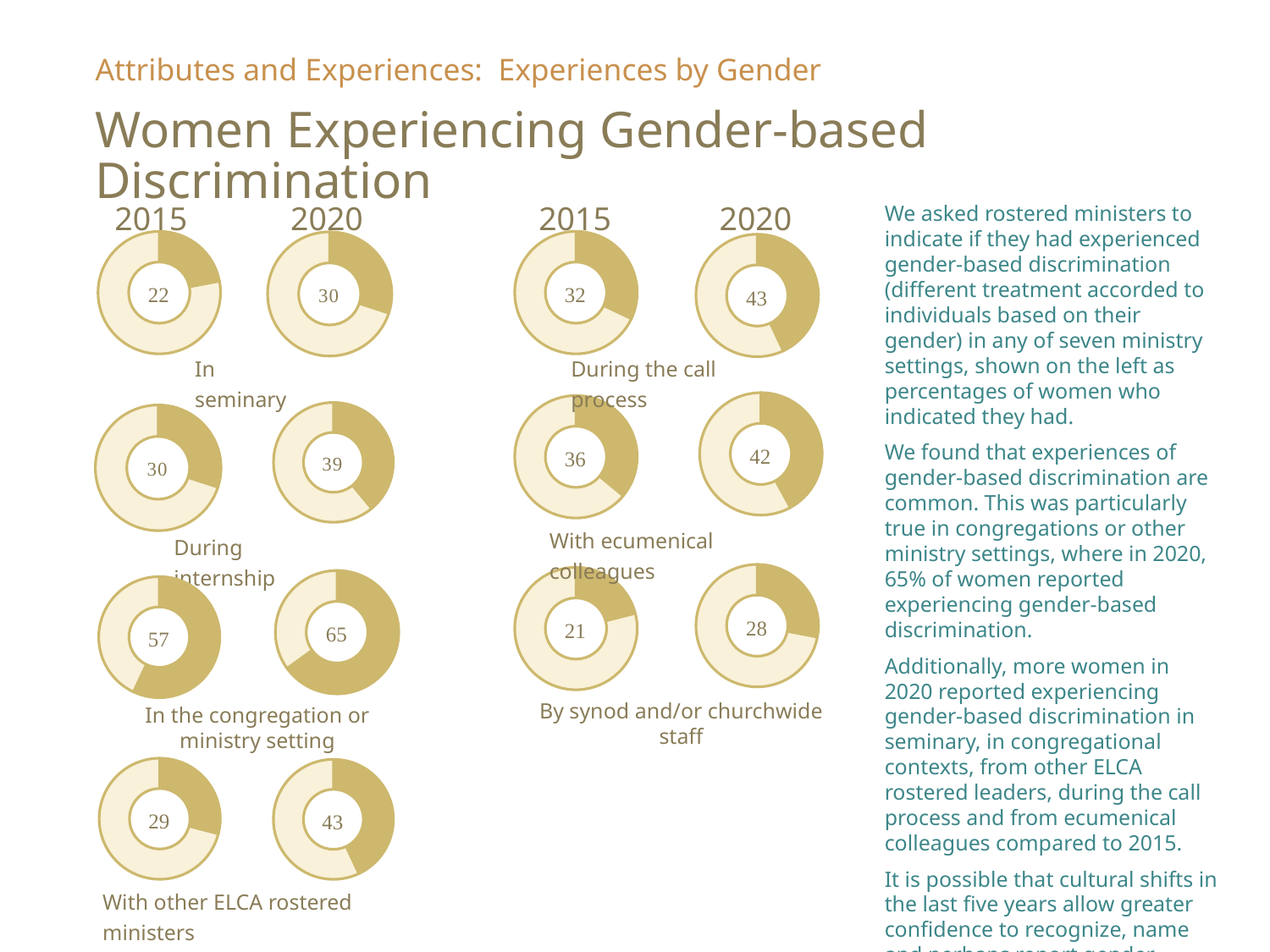
In the 'In seminary' charts, what value is shown in the 2020 donut chart? 30 In the 'By synod and/or churchwide staff' charts, what value is shown for 2020? 28 In the 'With ecumenical colleagues' charts, what is the difference between the 2020 value and the 2015 value? 6 In the 'In seminary' charts, what value is shown in the 2015 donut chart? 22 In the 'With other ELCA rostered ministers' charts, what value is shown for 2020? 43 In the 'In the congregation or ministry setting' charts, what value is shown for 2015? 57 Across all the 2020 donut charts on the slide, which ministry setting has the highest value? In the congregation or ministry setting In the 'During internship' charts, what value is shown for 2020? 39 In the 'During the call process' charts, what value is shown for 2015? 32 What type of chart is used to show the values on this slide? Donut chart Across all the 2015 donut charts on the slide, which ministry setting has the lowest value? By synod and/or churchwide staff In the 'In the congregation or ministry setting' charts, what is the difference between the 2020 value and the 2015 value? 8